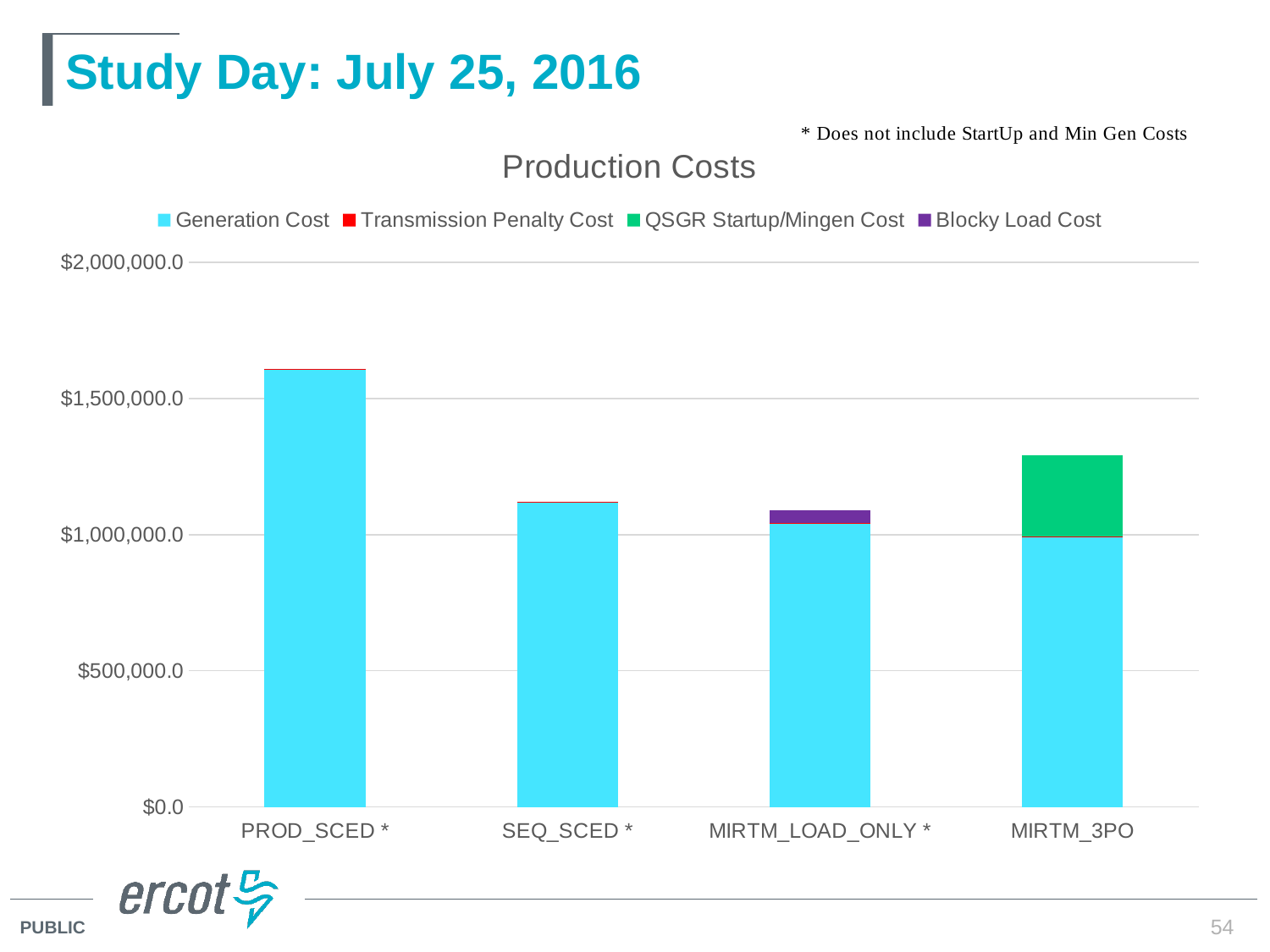
How many series does the legend of the Production Costs chart list? 4 Which has the larger total production cost, MIRTM_3PO or SEQ_SCED *? MIRTM_3PO How many categories are shown on the x axis of the Production Costs chart? 4 Is the total production cost for SEQ_SCED * greater or less than $1,000,000.0? greater What is the title of the chart? Production Costs Which category shows a visible Blocky Load Cost segment? MIRTM_LOAD_ONLY * What kind of chart is shown on the slide? Stacked bar chart Which category shows a visible QSGR Startup/Mingen Cost segment? MIRTM_3PO Which category has the highest total production cost? PROD_SCED * Is the total production cost for MIRTM_3PO greater or less than $1,500,000.0? less Which has the larger total production cost, PROD_SCED * or MIRTM_3PO? PROD_SCED * Is the total production cost for PROD_SCED * greater or less than $1,500,000.0? greater